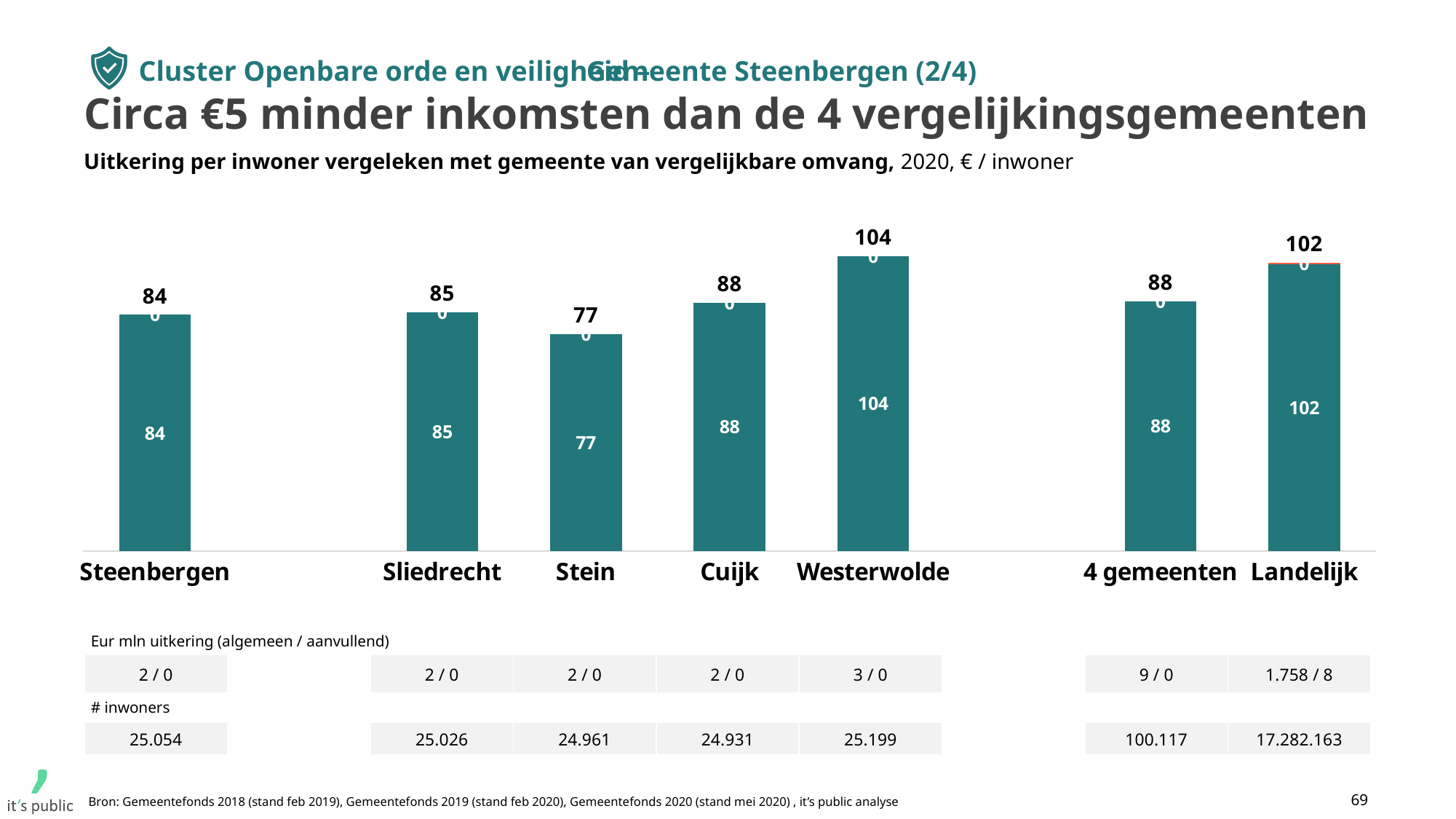
What is the difference between the values for Westerwolde and Steenbergen? 20 Which category has the lowest value? Stein What is the value for Westerwolde? 104 Which category has the highest value? Westerwolde What is the value for Stein? 77 How many categories are shown on the x axis? 7 What is the difference between the values for 4 gemeenten and Steenbergen? 4 What is the value for Landelijk? 102 Which is larger, the value for Cuijk or the value for Sliedrecht? Cuijk What kind of chart is shown on the slide? bar chart What is the value for Steenbergen? 84 What is the unit stated in the chart subtitle? € / inwoner